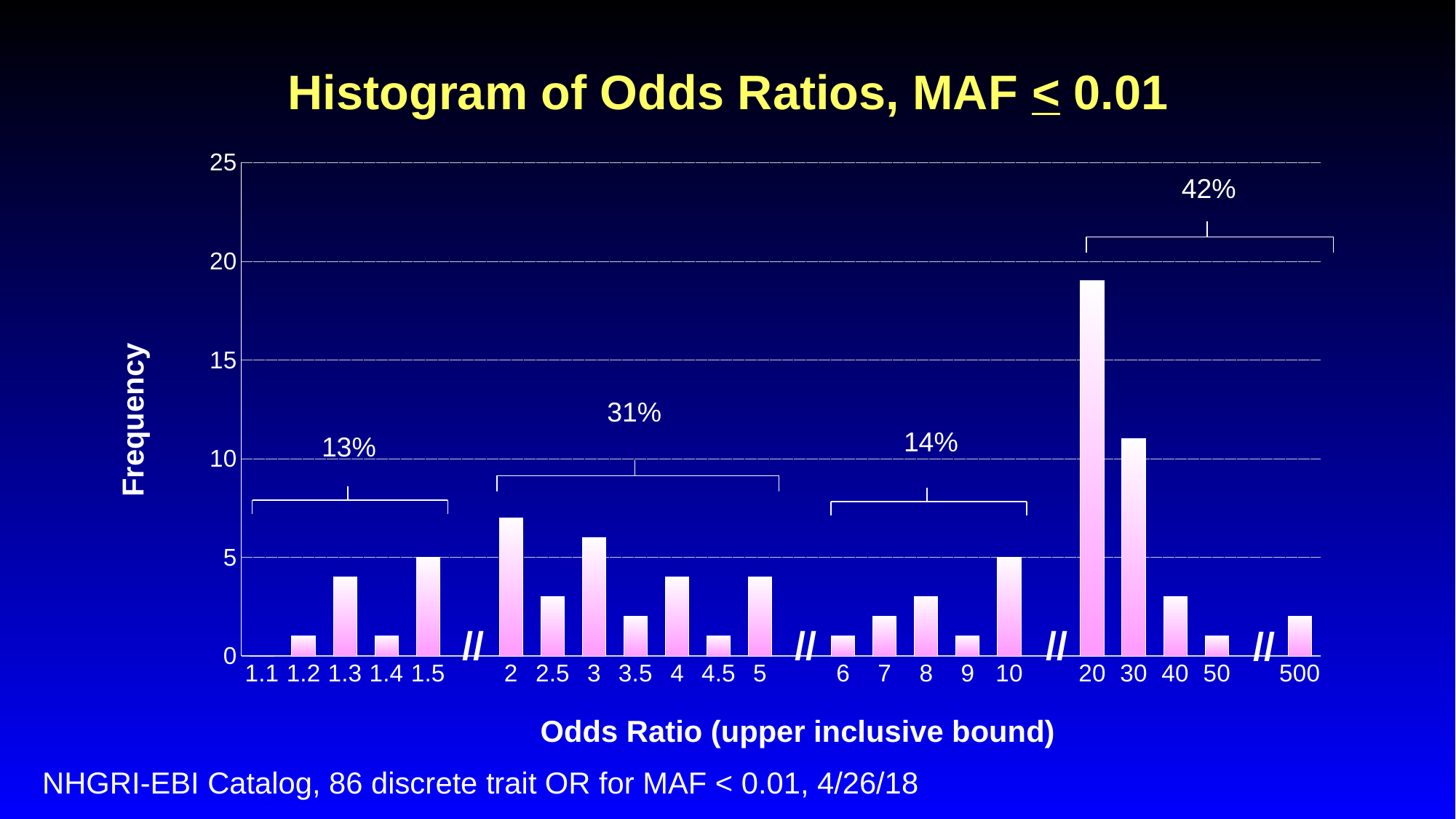
What percentage is printed above the group of bars from 20 to 500? 42% Which has a higher frequency, the odds ratio category 2 or 2.5? 2 What is the frequency for the odds ratio category 10? 5 Is the frequency for the odds ratio category 20 greater or less than 15? greater Is the frequency for the odds ratio category 30 greater or less than 10? greater How many odds ratio categories are shown on the x axis? 22 What is the frequency for the odds ratio category 1.5? 5 Is the frequency for the odds ratio category 2 greater or less than 5? greater Which has a higher frequency, the odds ratio category 20 or 30? 20 What kind of chart is shown on the slide? bar chart Which odds ratio category has the highest frequency? 20